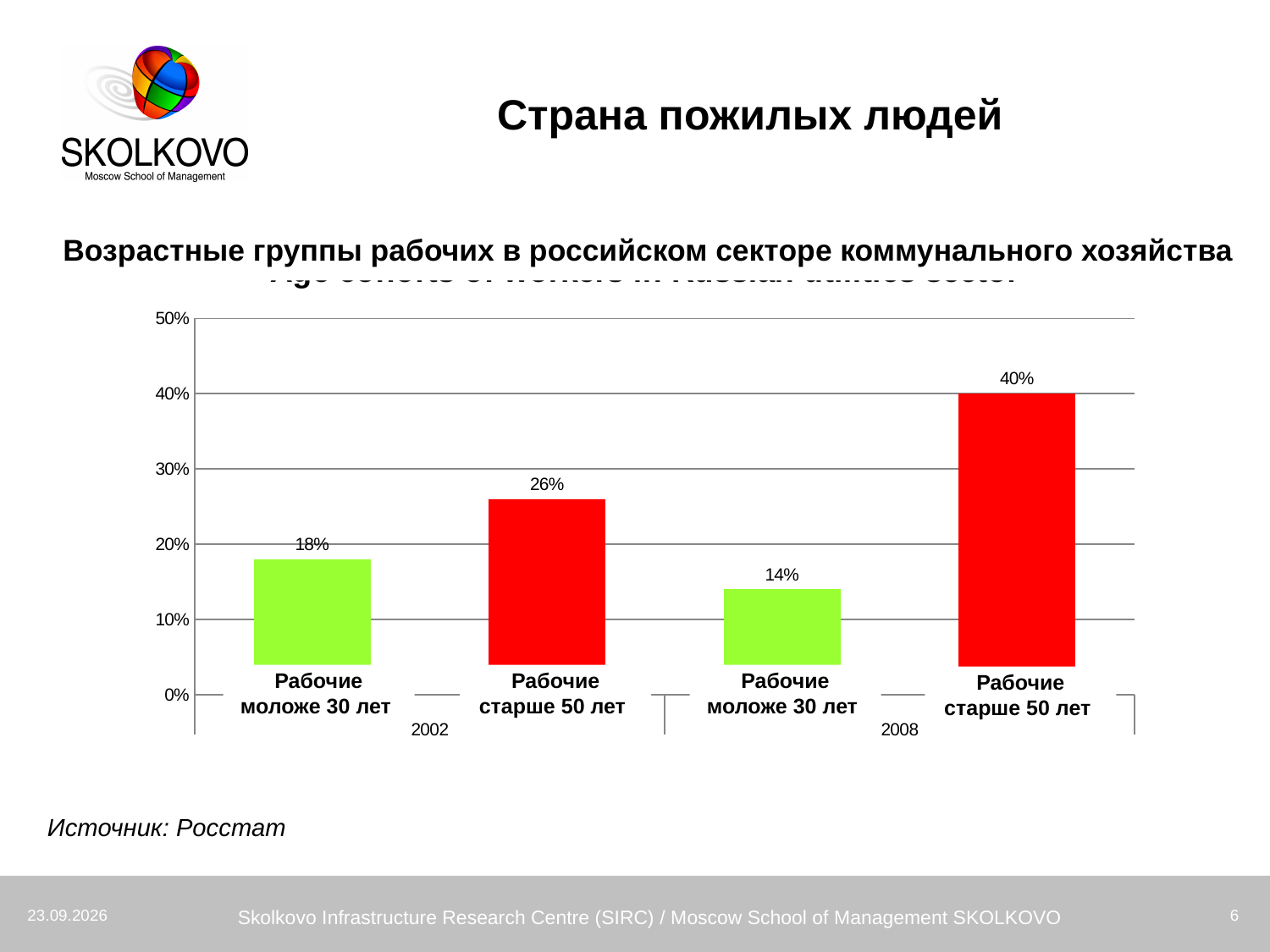
How many bars are plotted in the chart? 4 What source is cited below the chart? Росстат What is the value for workers over 50 (Рабочие старше 50 лет) in 2002? 26% What is the difference between the share of workers over 50 in 2008 and in 2002? 14% What is the difference between the share of workers under 30 in 2002 and in 2008? 4% Which is larger: the share of workers under 30 in 2002 or the share of workers over 50 in 2002? Рабочие старше 50 лет (26%) What is the value for workers under 30 (Рабочие моложе 30 лет) in 2008? 14% What kind of chart is shown on the slide? Bar chart Which bar has the lowest value? Рабочие моложе 30 лет, 2008 What is the value for workers over 50 (Рабочие старше 50 лет) in 2008? 40% What is the value for workers under 30 (Рабочие моложе 30 лет) in 2002? 18% Which bar has the highest value? Рабочие старше 50 лет, 2008